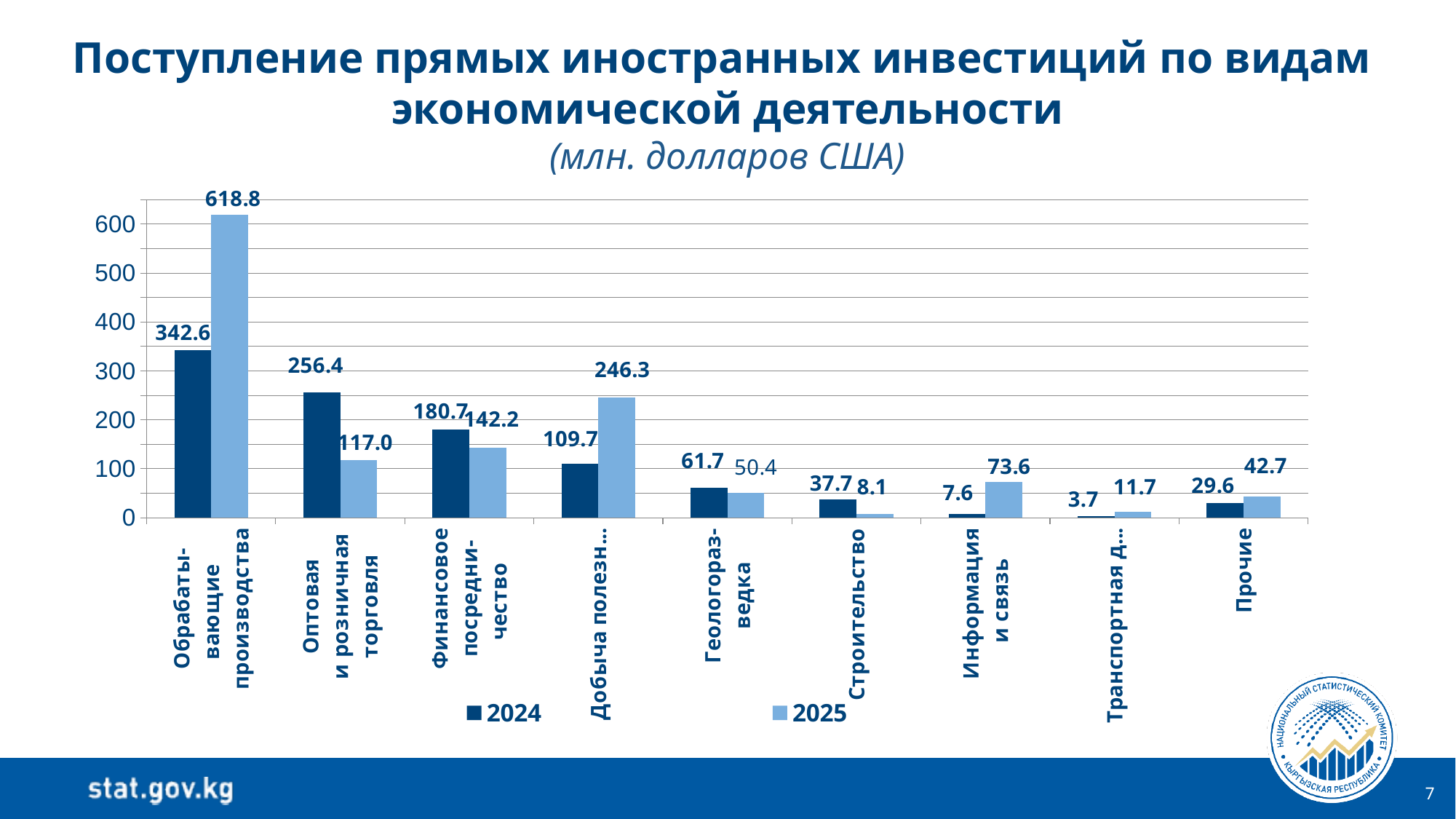
How many series does the legend list? 2 Which category has the highest 2025 value? Обрабатывающие производства How many categories are shown on the x axis? 9 Which is larger for Финансовое посредничество: the 2024 value or the 2025 value? 2024 What is the 2024 value for Оптовая и розничная торговля? 256.4 What is the 2025 value for Информация и связь? 73.6 What is the difference between the 2025 and 2024 values for Обрабатывающие производства? 276.2 What unit is given in the chart title? млн. долларов США What kind of chart is shown on the slide? Bar chart What is the 2024 value for Строительство? 37.7 What is the 2025 value for Обрабатывающие производства? 618.8 Which category has the lowest 2025 value? Строительство